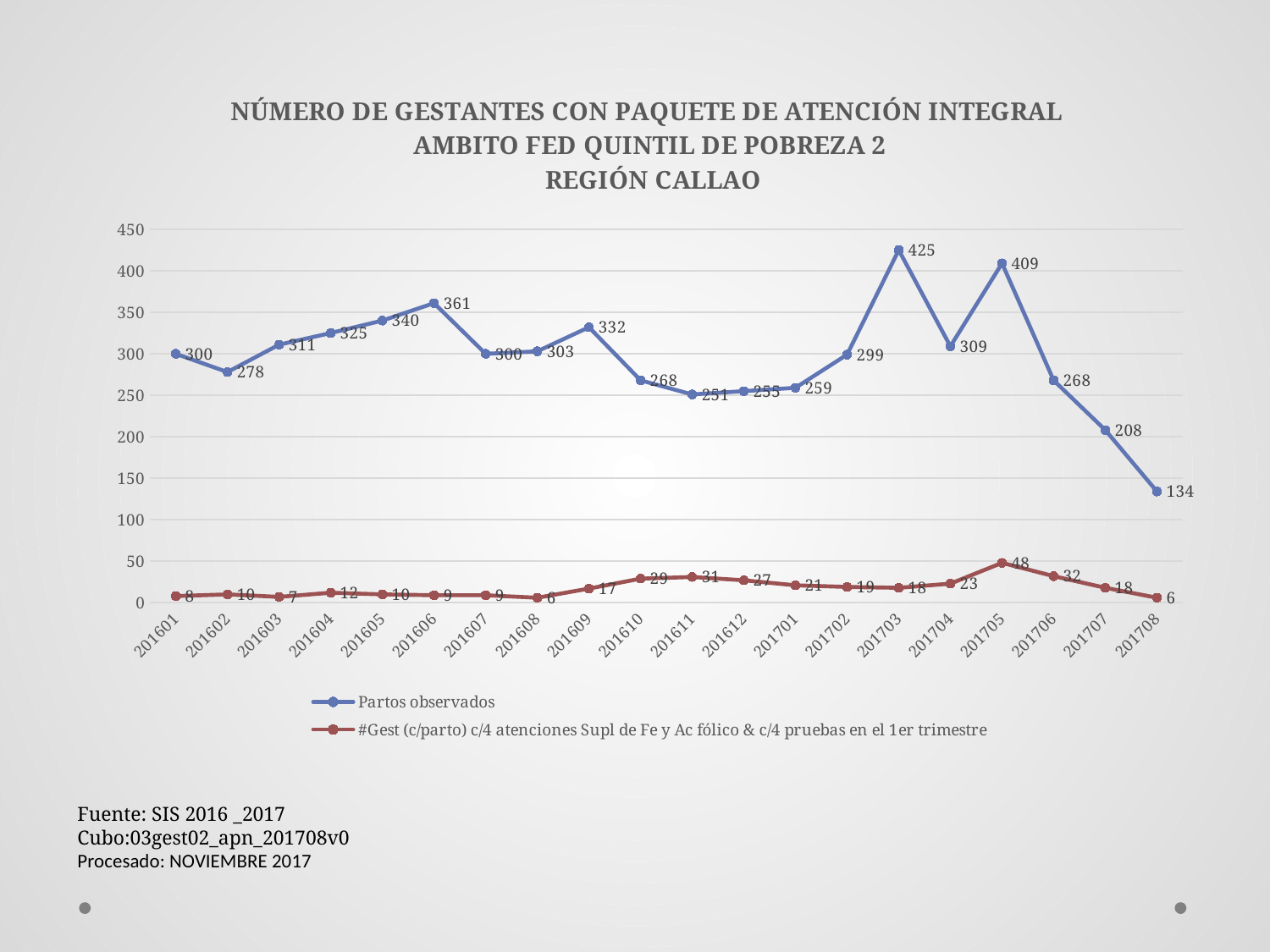
How many series does the legend list? 2 In which period does Partos observados reach its highest value? 201703 How many periods are plotted along the x axis? 20 In which period does Partos observados reach its lowest value? 201708 What is the difference between Partos observados in 201703 and in 201708? 291 Which region is named in the chart title? Región Callao What is the value of the series '#Gest (c/parto) c/4 atenciones Supl de Fe y Ac fólico & c/4 pruebas en el 1er trimestre' for 201705? 48 Which period has a higher value of Partos observados, 201706 or 201707? 201706 What is the value of Partos observados for 201708? 134 What is the value of Partos observados for 201703? 425 Does Partos observados rise or fall from 201705 to 201708? Fall What kind of chart is shown on the slide? Line chart